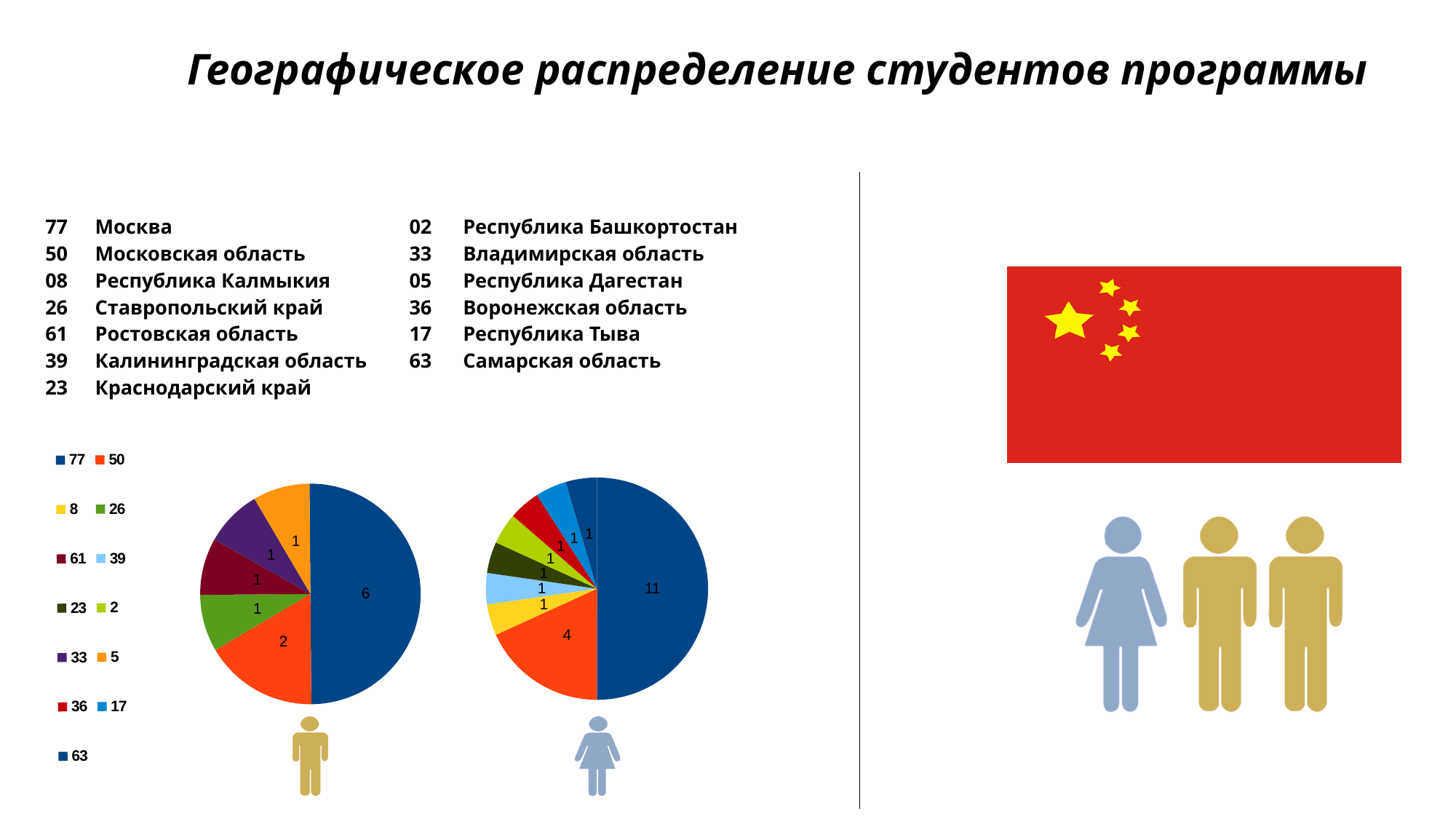
Which pie chart has the larger orange slice value, the left one or the right one? The right one In the left pie chart (above the male figure), what is the value of the largest slice? 6 In the left pie chart, which legend entry corresponds to the largest slice? 77 How many slices does the right pie chart have? 9 What is the total of all slice values in the left pie chart? 12 What kind of charts are shown on the left half of the slide? Pie charts In the right pie chart (above the female figure), what is the value of the largest slice? 11 How many entries does the legend list for the pie charts? 13 In the right pie chart, what is the value of the orange slice? 4 How many slices does the left pie chart have? 6 What is the difference between the largest slice of the right pie chart and the largest slice of the left pie chart? 5